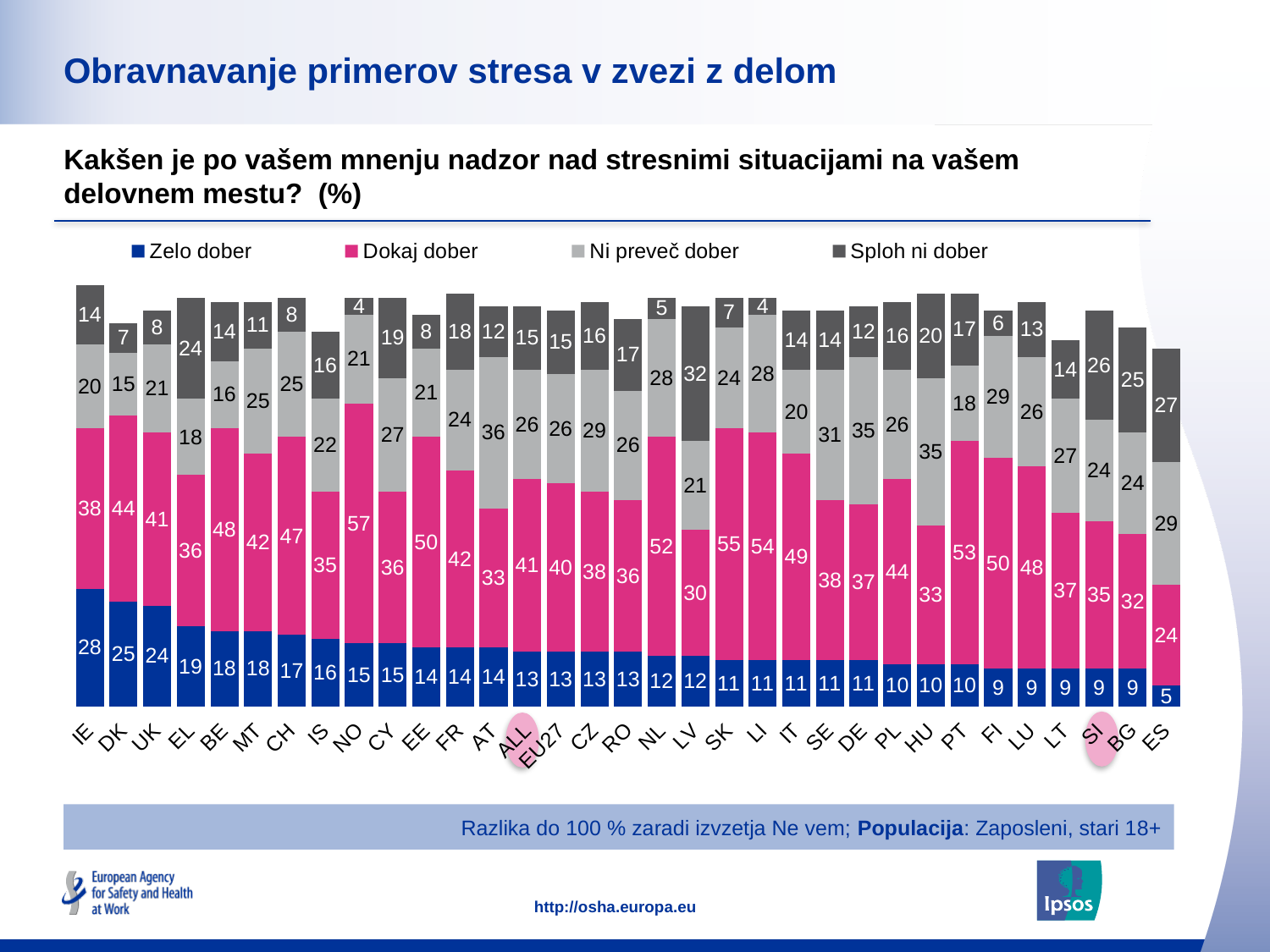
What is the "Sploh ni dober" value for LV? 32 How many countries or groups are shown on the x axis? 33 Which country has the highest "Zelo dober" value? IE What kind of chart is shown on the slide? Stacked bar chart Which has a larger "Ni preveč dober" value, AT or IE? AT How many series does the legend list? 4 What is the "Dokaj dober" value for NO? 57 Which country has the lowest "Zelo dober" value? ES What is the total of the stacked bar for DK? 91 What percentage of respondents in IE answered "Zelo dober"? 28 Which legend entry is shown in blue? Zelo dober What is the difference between the "Dokaj dober" values for NO and ES? 33